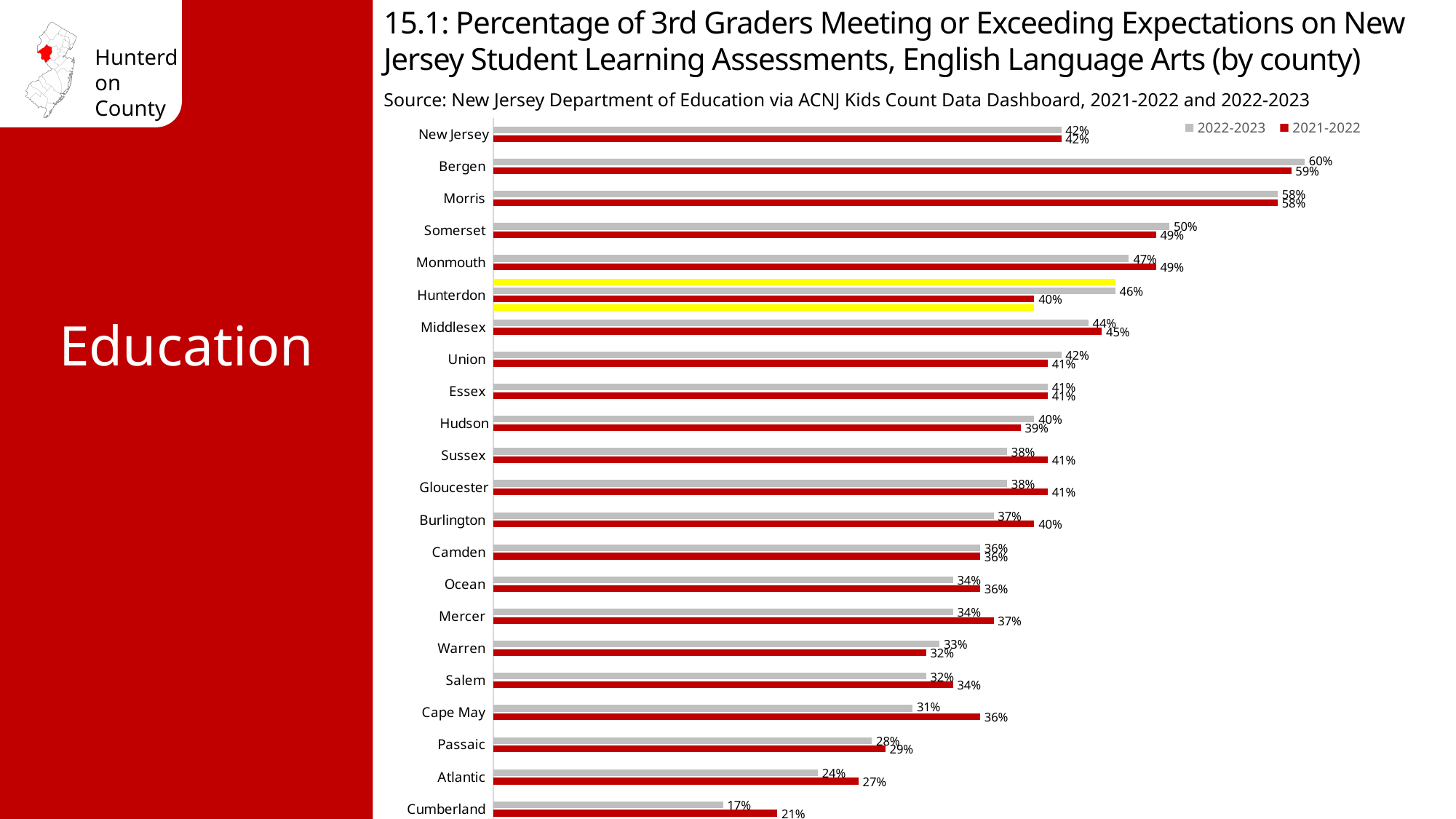
Which is larger for Monmouth: the 2022-2023 value or the 2021-2022 value? 2021-2022 What is the 2022-2023 value for Bergen? 60% What is the 2021-2022 value for Hunterdon? 40% What is the 2021-2022 value for Cape May? 36% What is the 2022-2023 value for Hunterdon? 46% Which county has the lowest 2021-2022 value? Cumberland What is the difference between Hunterdon's 2022-2023 and 2021-2022 values? 6 percentage points How many categories (counties plus New Jersey) are shown on the chart? 22 Which county has the highest 2022-2023 value? Bergen Which colour represents the 2021-2022 series in the legend? Red What kind of chart is shown on the slide? Bar chart How many series does the legend list? 2